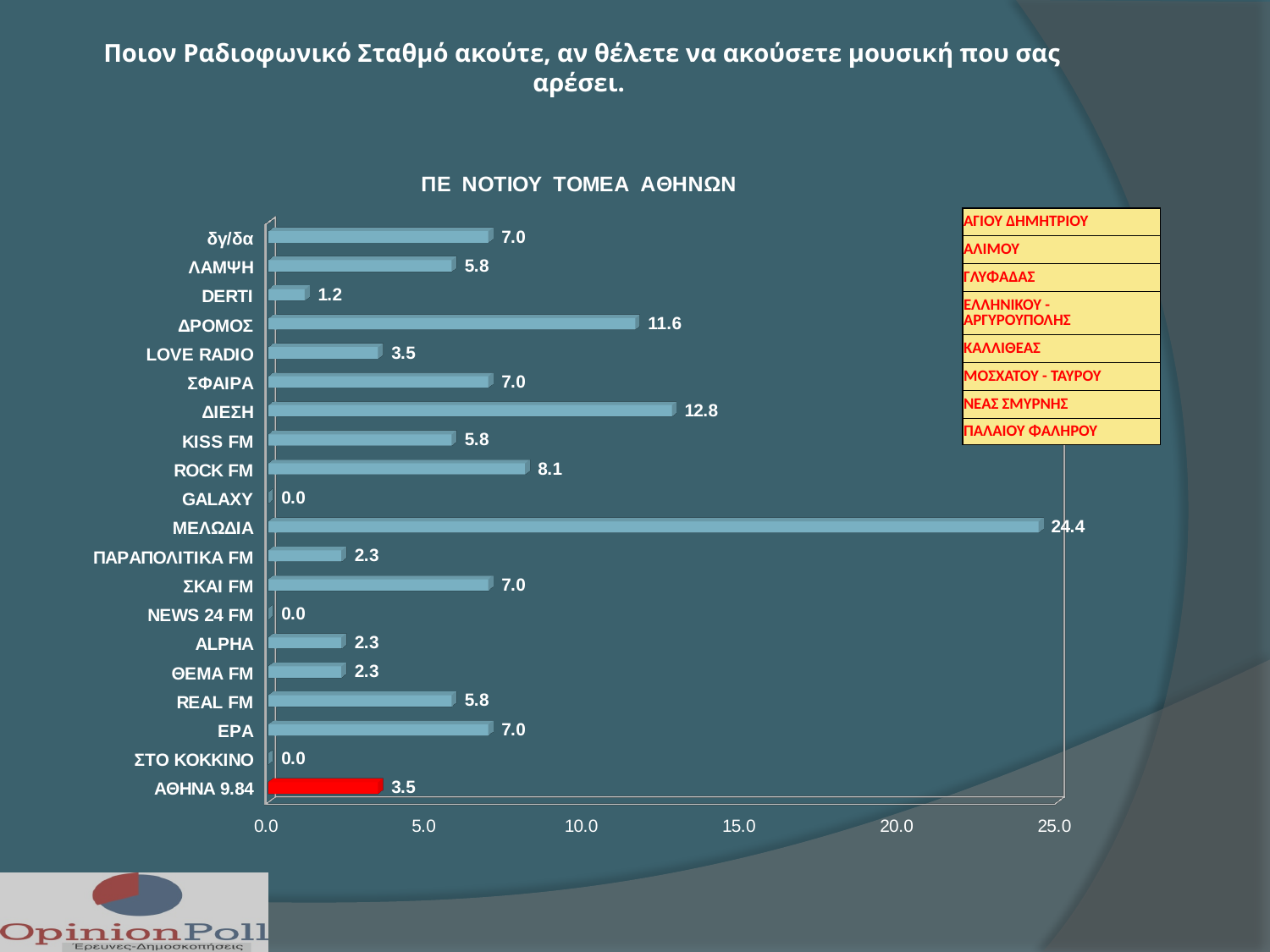
Which radio station has the highest value? ΜΕΛΩΔΙΑ Which has a larger value, ΔΙΕΣΗ or ΔΡΟΜΟΣ? ΔΙΕΣΗ Which radio station's bar is coloured red? ΑΘΗΝΑ 9.84 What is the value for ΔΙΕΣΗ? 12.8 What is the value for ΑΘΗΝΑ 9.84? 3.5 What type of chart is shown on the slide? bar chart What is the value for DERTI? 1.2 How many radio stations have a value of 0.0? 3 What is the value for ΜΕΛΩΔΙΑ? 24.4 What is the difference between the values for ΜΕΛΩΔΙΑ and ΔΙΕΣΗ? 11.6 What is the difference between the values for ΔΡΟΜΟΣ and ROCK FM? 3.5 How many radio stations are listed on the chart? 19